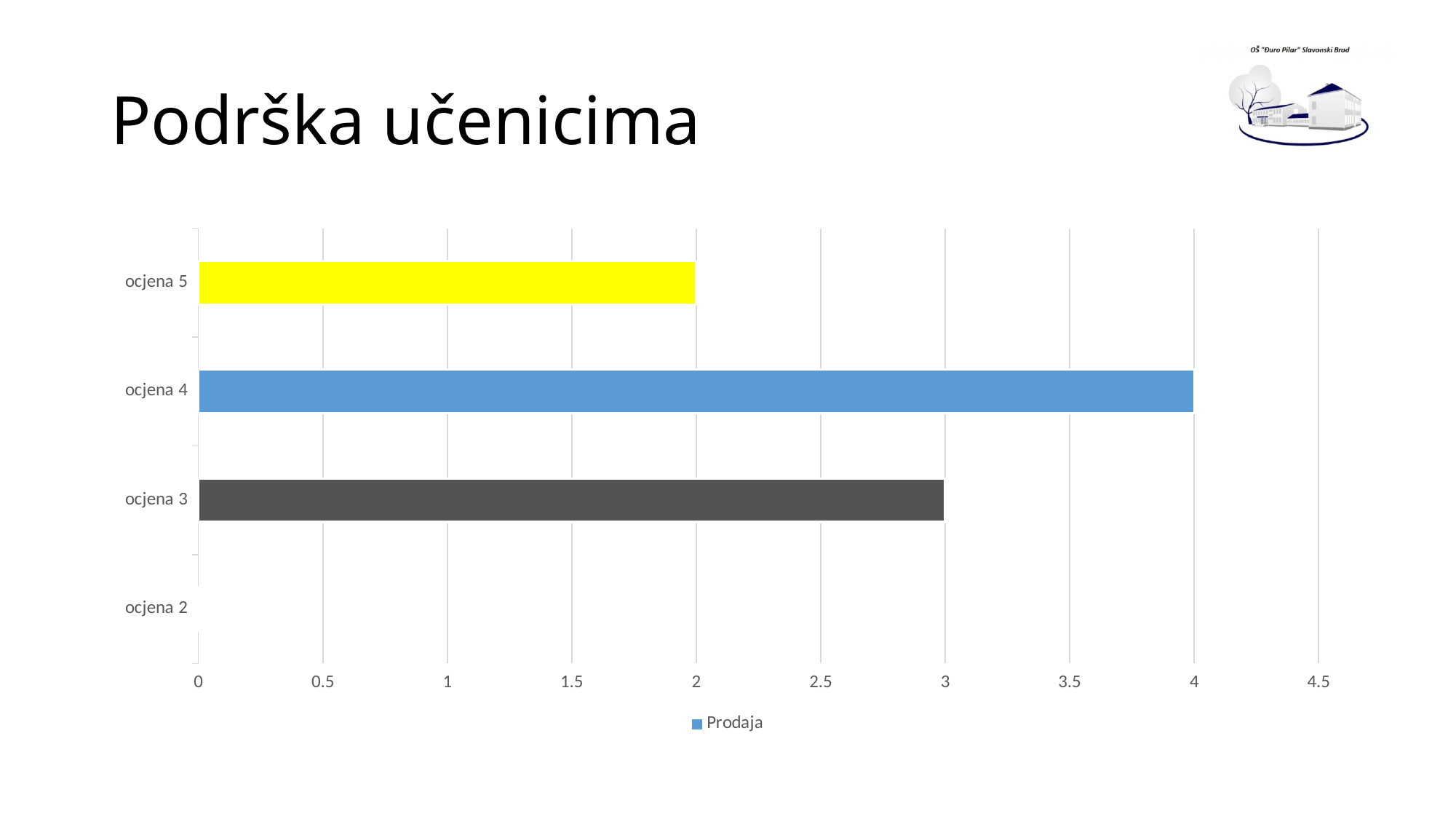
What is the name of the series in the legend? Prodaja What is the difference between the values for ocjena 4 and ocjena 5? 2 Is the value for ocjena 4 greater or less than 3.5? greater How many categories are shown on the chart? 4 Which category has the lowest value? ocjena 2 What is the value for ocjena 4? 4 What kind of chart is shown on the slide? bar chart Which is larger, the value for ocjena 3 or the value for ocjena 5? ocjena 3 What is the value for ocjena 5? 2 Which category has the highest value? ocjena 4 How many series does the legend list? 1 What is the value for ocjena 3? 3